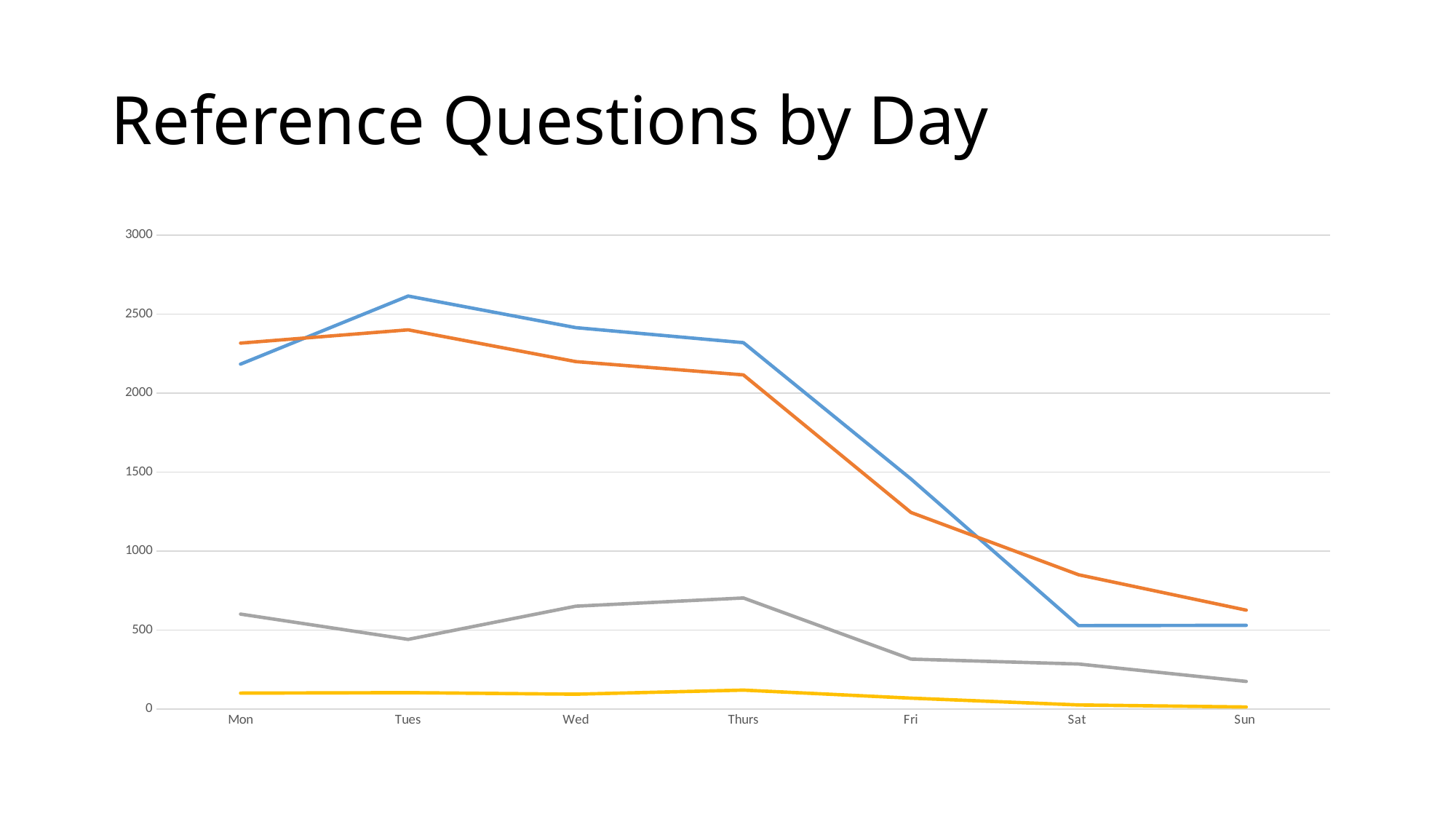
On which day does the orange line reach its lowest value? Sun Is the value of the blue line on Tues greater or less than 2500? greater What is the title of the chart? Reference Questions by Day How many lines are plotted on the chart? 4 On which day does the blue line reach its highest value? Tues How many days are shown on the x axis? 7 On Sat, which line has the larger value, the blue line or the orange line? orange line Is the value of the gray line on Mon greater or less than 500? greater What kind of chart is shown on the slide? line chart Does the blue line rise or fall from Thurs to Sat? fall Is the value of the orange line on Fri greater or less than 1000? greater